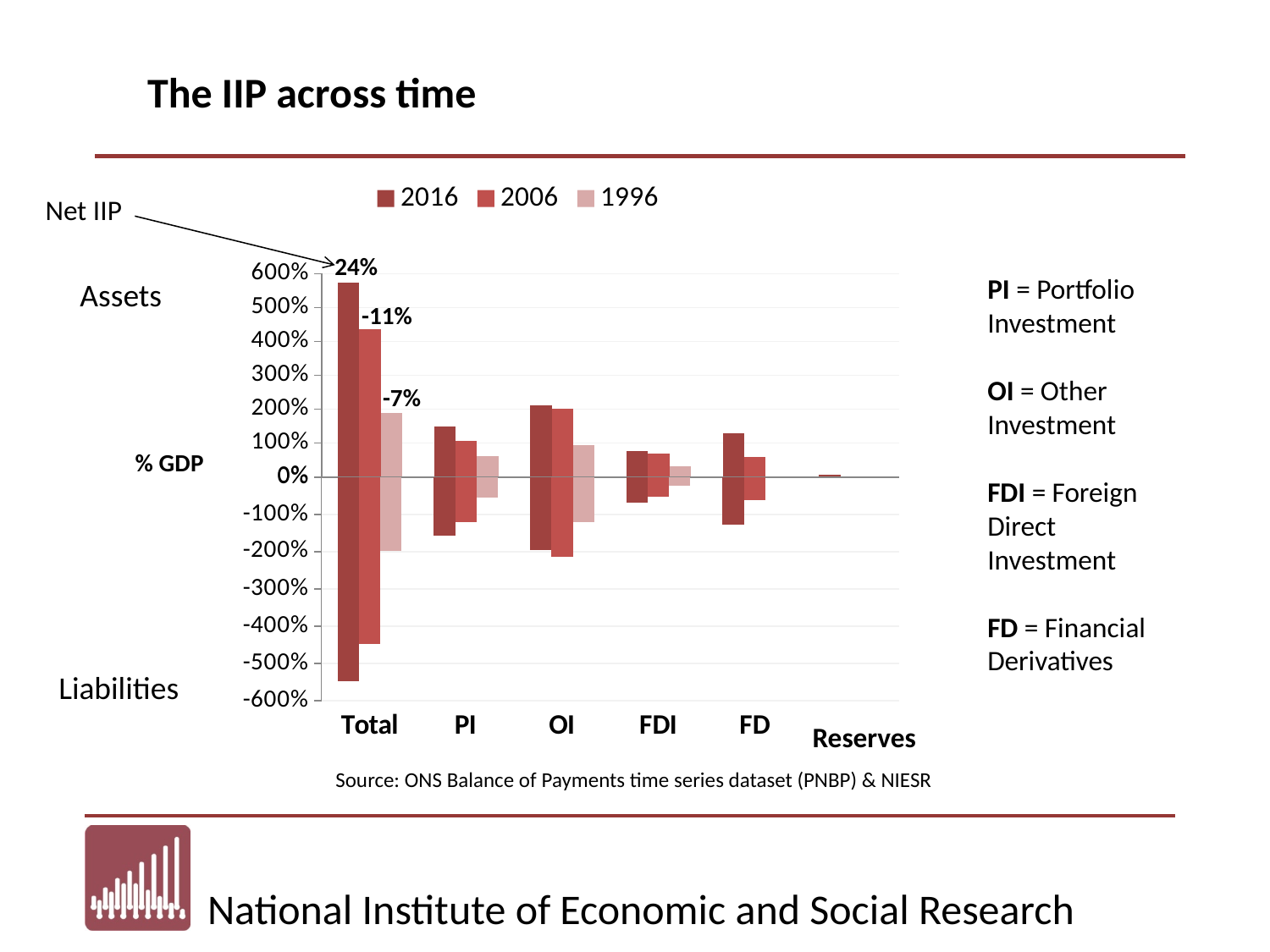
Which years are listed in the chart legend? 2016, 2006, 1996 How many categories are shown along the x axis? 6 Is the 2006 assets value for Total greater or less than 400%? greater Which is larger, the 2016 assets bar for Total or the 2006 assets bar for Total? 2016 Which category has the tallest 2016 assets bar? Total What Net IIP value is labelled for 2006 on the Total category? -11% What kind of chart is shown on the slide? bar chart Is the 2016 liabilities value for Total greater or less than -500%? less What Net IIP value is labelled for 2016 above the Total category? 24% How many series does the legend list? 3 What Net IIP value is labelled for 1996 on the Total category? -7% Is the 2016 assets value for Total greater or less than 500%? greater